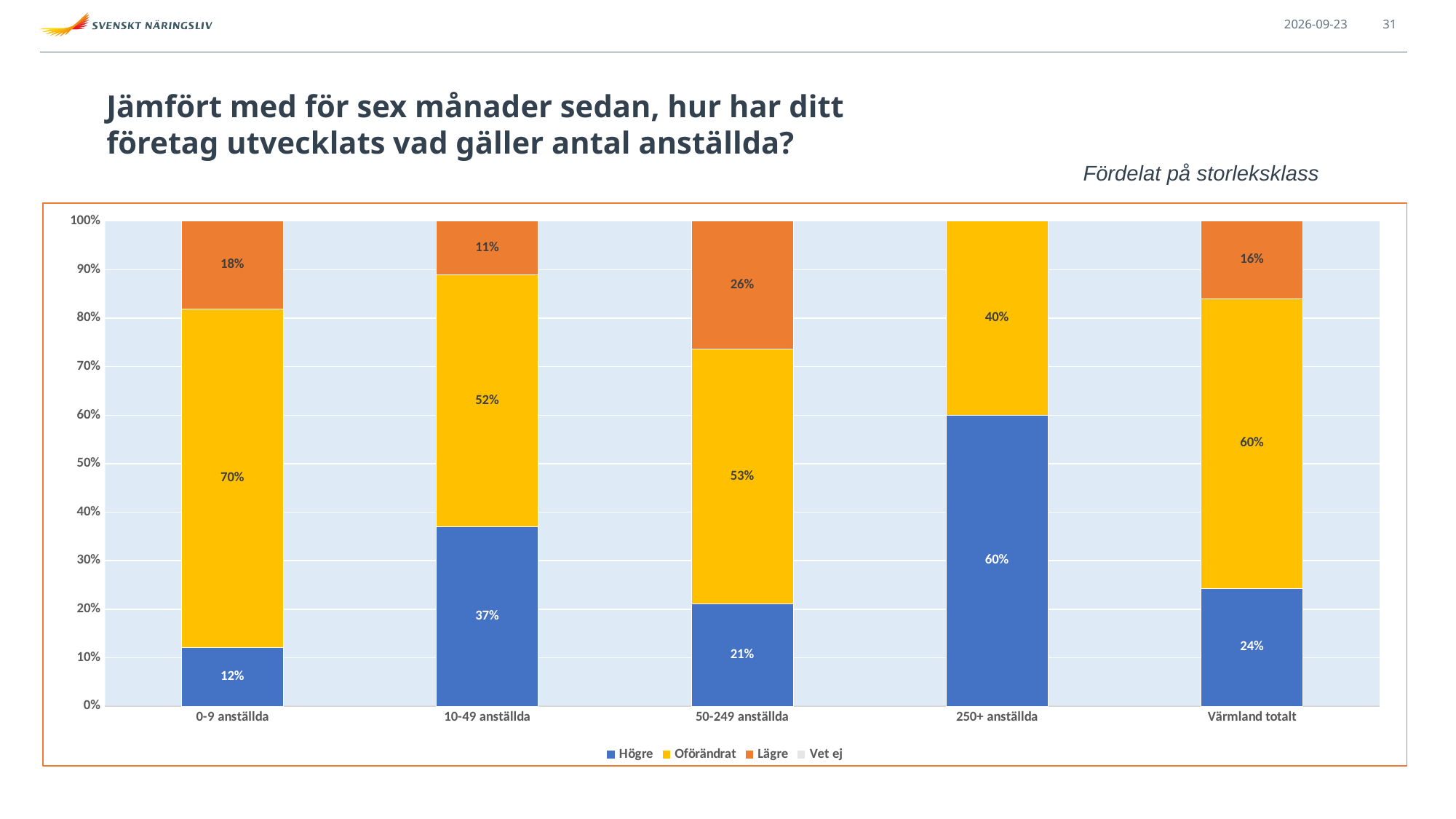
How many series does the legend list? 4 What kind of chart is shown on the slide? Stacked bar chart What is the value for Lägre in the 50-249 anställda category? 26% What is the value for Högre in the 0-9 anställda category? 12% What is the difference between the Oförändrat values for 0-9 anställda and Värmland totalt? 10 percentage points What is the value for Oförändrat in the 10-49 anställda category? 52% How many categories are shown on the x axis? 5 Which legend entry is shown in blue? Högre Which is larger: the Lägre value for 0-9 anställda or for 10-49 anställda? 0-9 anställda What is the value for Högre in the Värmland totalt category? 24% Which category has the lowest value for Oförändrat? 250+ anställda Which category has the highest value for Högre? 250+ anställda